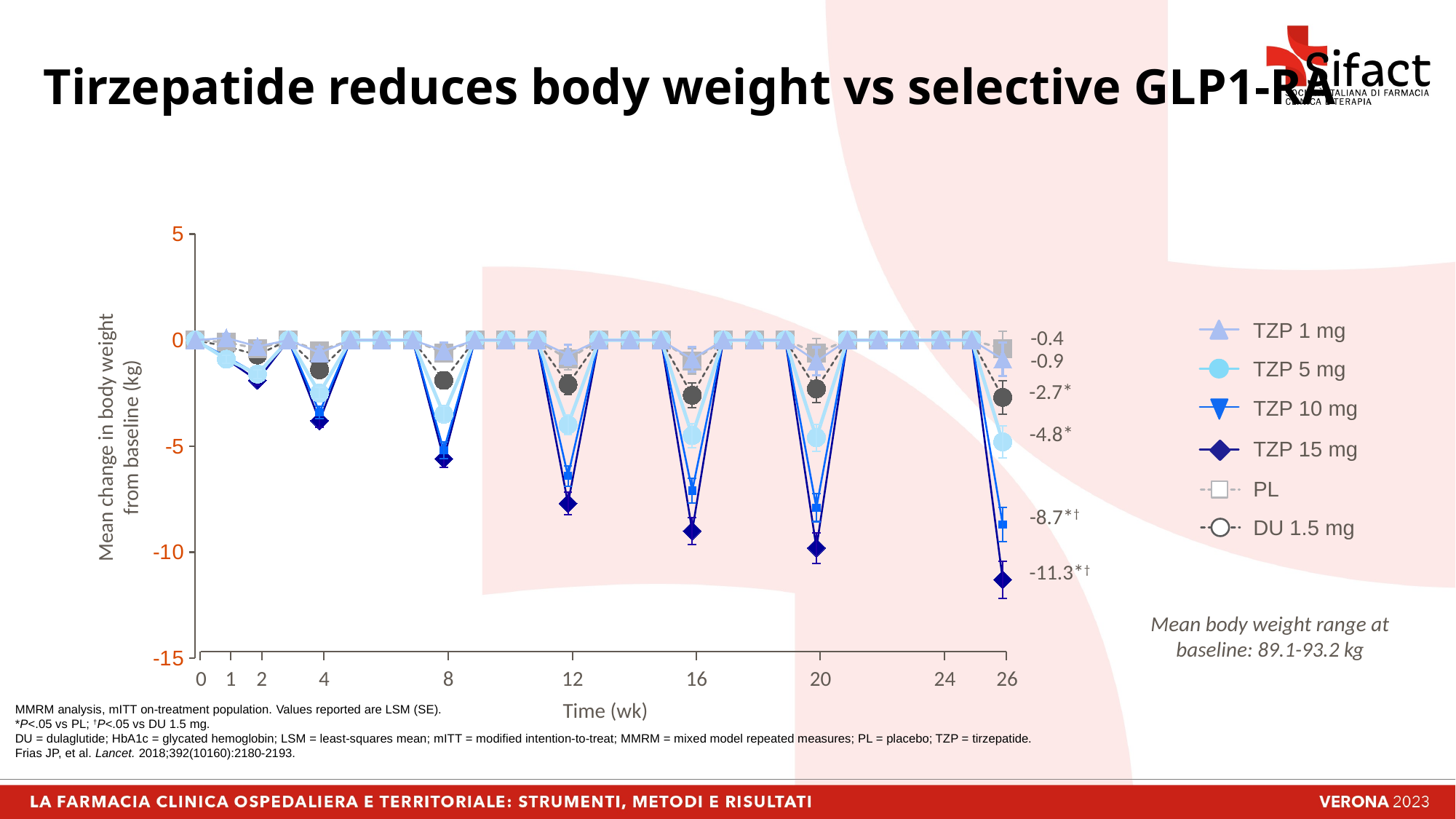
What is the label of the y axis? Mean change in body weight from baseline (kg) Is the value for TZP 15 mg at week 26 greater or less than -10? less What is the mean change in body weight from baseline at week 26 for PL? -0.4 What is the mean change in body weight from baseline at week 26 for TZP 15 mg? -11.3 What is the mean change in body weight from baseline at week 26 for TZP 10 mg? -8.7 Which series shows the largest reduction in body weight at week 26? TZP 15 mg What is the difference between the week 26 values for TZP 15 mg (-11.3) and TZP 10 mg (-8.7)? 2.6 At week 26, which shows a greater weight reduction: TZP 5 mg or DU 1.5 mg? TZP 5 mg Which series shows the smallest change in body weight at week 26? PL How many series does the legend list? 6 What is the mean change in body weight from baseline at week 26 for DU 1.5 mg? -2.7 What type of chart is shown on the slide? Line chart